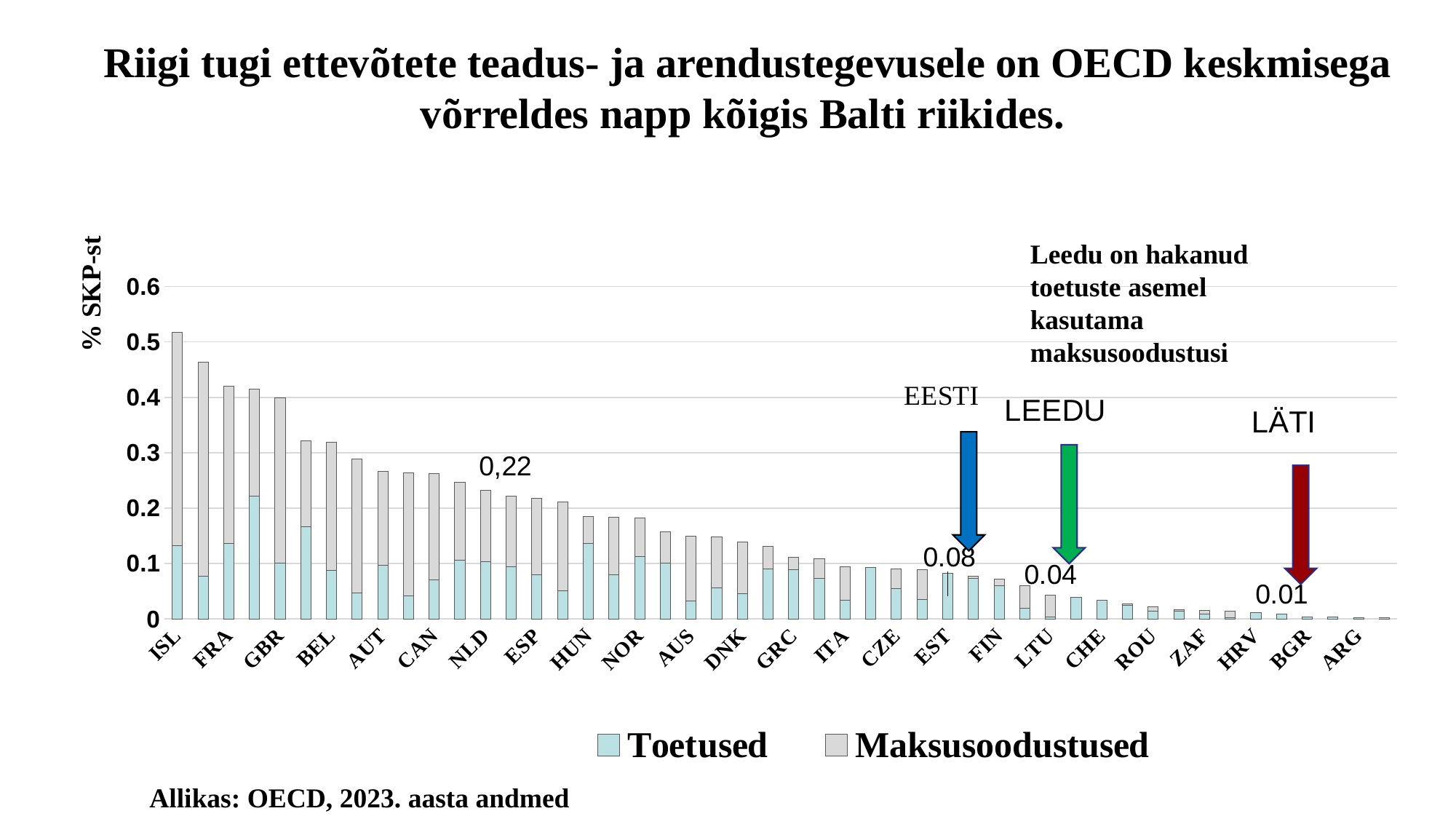
How many series does the legend list? 2 Is the total value for GBR greater or less than 0.5? less Do the total bar values rise or fall from left to right along the x axis? fall What is the difference between the value labelled under the EESTI arrow (0.08) and the value labelled under the LEEDU arrow (0.04)? 0.04 What are the two series named in the legend? Toetused and Maksusoodustused What value is printed as the data label under the LEEDU arrow? 0.04 What value is printed as the data label under the LÄTI arrow? 0.01 What kind of chart is shown on the slide? stacked bar chart Which has the larger total bar, ISL or FRA? ISL What value is printed as the data label under the EESTI arrow? 0.08 Which country has the highest total bar? ISL Is the total value for FRA greater or less than 0.4? greater